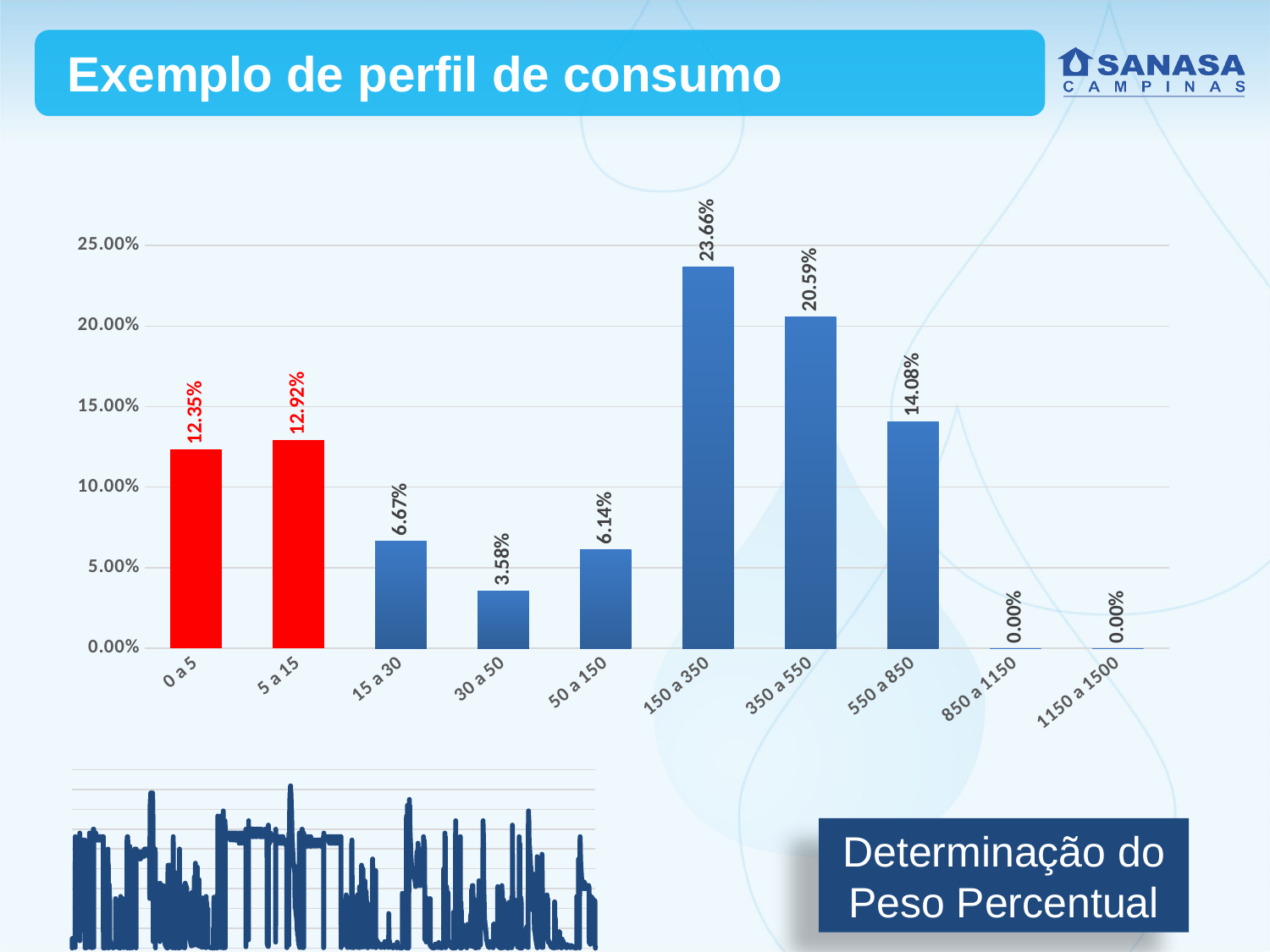
In the main bar chart, which categories are drawn in red? 0 a 5 and 5 a 15 In the main bar chart, is the value for 550 a 850 greater or less than 10.00%? greater In the main bar chart, what is the difference between the values for 150 a 350 and 350 a 550? 3.07% In the main bar chart, what is the value for the category 150 a 350? 23.66% In the main bar chart, what is the value for the category 5 a 15? 12.92% In the main bar chart, what is the difference between the values for 550 a 850 and 15 a 30? 7.41% In the main bar chart, which is larger: the value for 0 a 5 or the value for 5 a 15? 5 a 15 What kind of chart is the main chart on the slide? bar chart In the main bar chart, what is the value for the category 30 a 50? 3.58% How many categories are shown on the x axis of the main bar chart? 10 In the main bar chart, which category has the highest value? 150 a 350 In the main bar chart, what is the value for the category 850 a 1150? 0.00%